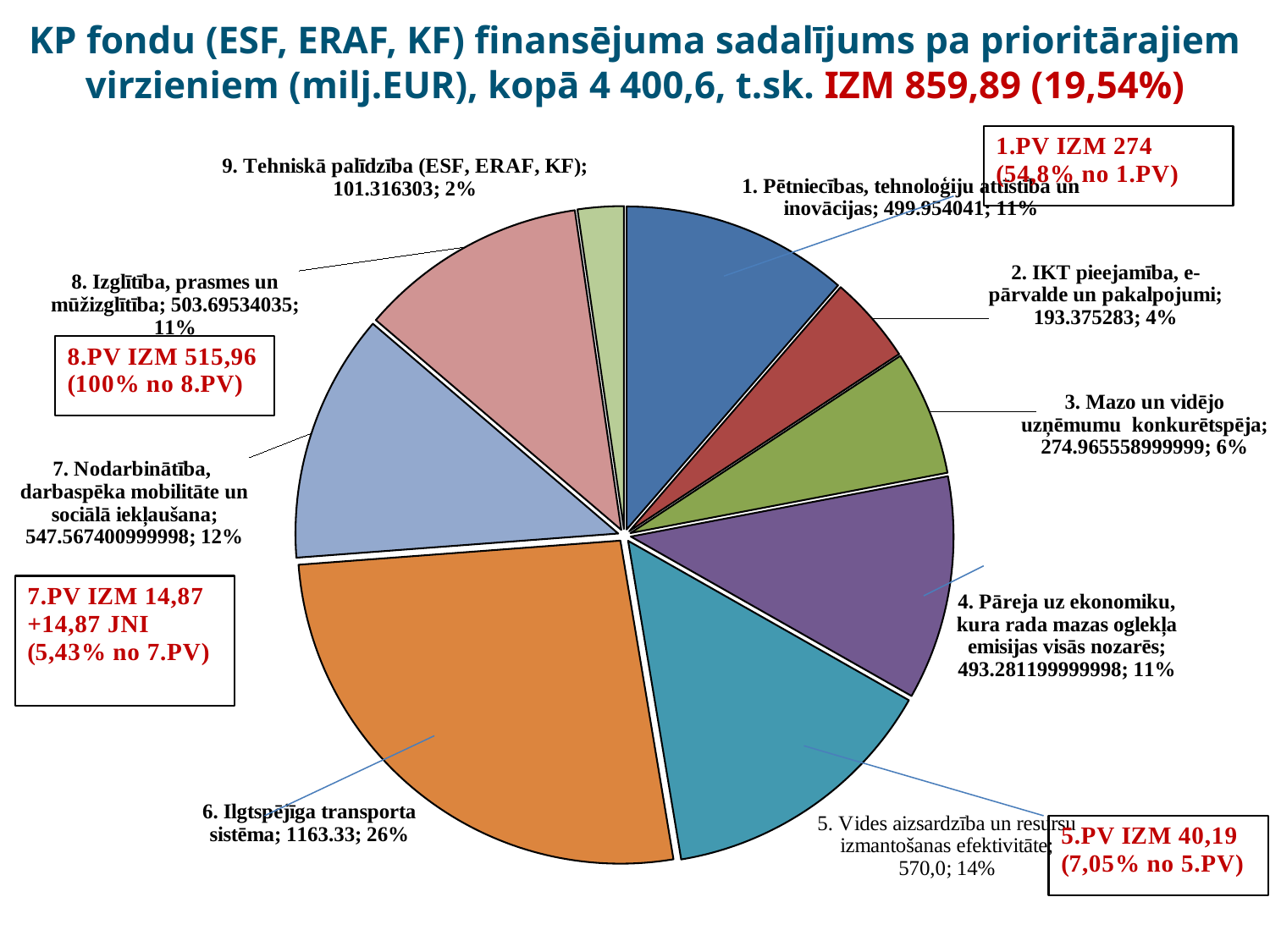
What is the value shown for '6. Ilgtspējīga transporta sistēma'? 1163.33 What share of the pie does '7. Nodarbinātība, darbaspēka mobilitāte un sociālā iekļaušana' represent? 12% Which category has the largest slice of the pie? 6. Ilgtspējīga transporta sistēma What percentage is shown for '3. Mazo un vidējo uzņēmumu konkurētspēja'? 6% Which is larger, the value for '6. Ilgtspējīga transporta sistēma' or the value for '5. Vides aizsardzība un resursu izmantošanas efektivitāte'? 6. Ilgtspējīga transporta sistēma What kind of chart is shown on the slide? pie chart What is the difference between the value for '6. Ilgtspējīga transporta sistēma' (1163.33) and the value for '9. Tehniskā palīdzība (ESF, ERAF, KF)' (101.316303)? 1062.013697 How many slices does the pie chart have? 9 What colour is the largest slice of the pie chart? orange Which category has the smallest slice of the pie? 9. Tehniskā palīdzība (ESF, ERAF, KF) What is the value shown for '2. IKT pieejamība, e-pārvalde un pakalpojumi'? 193.375283 What share of the pie does '5. Vides aizsardzība un resursu izmantošanas efektivitāte' represent? 14%